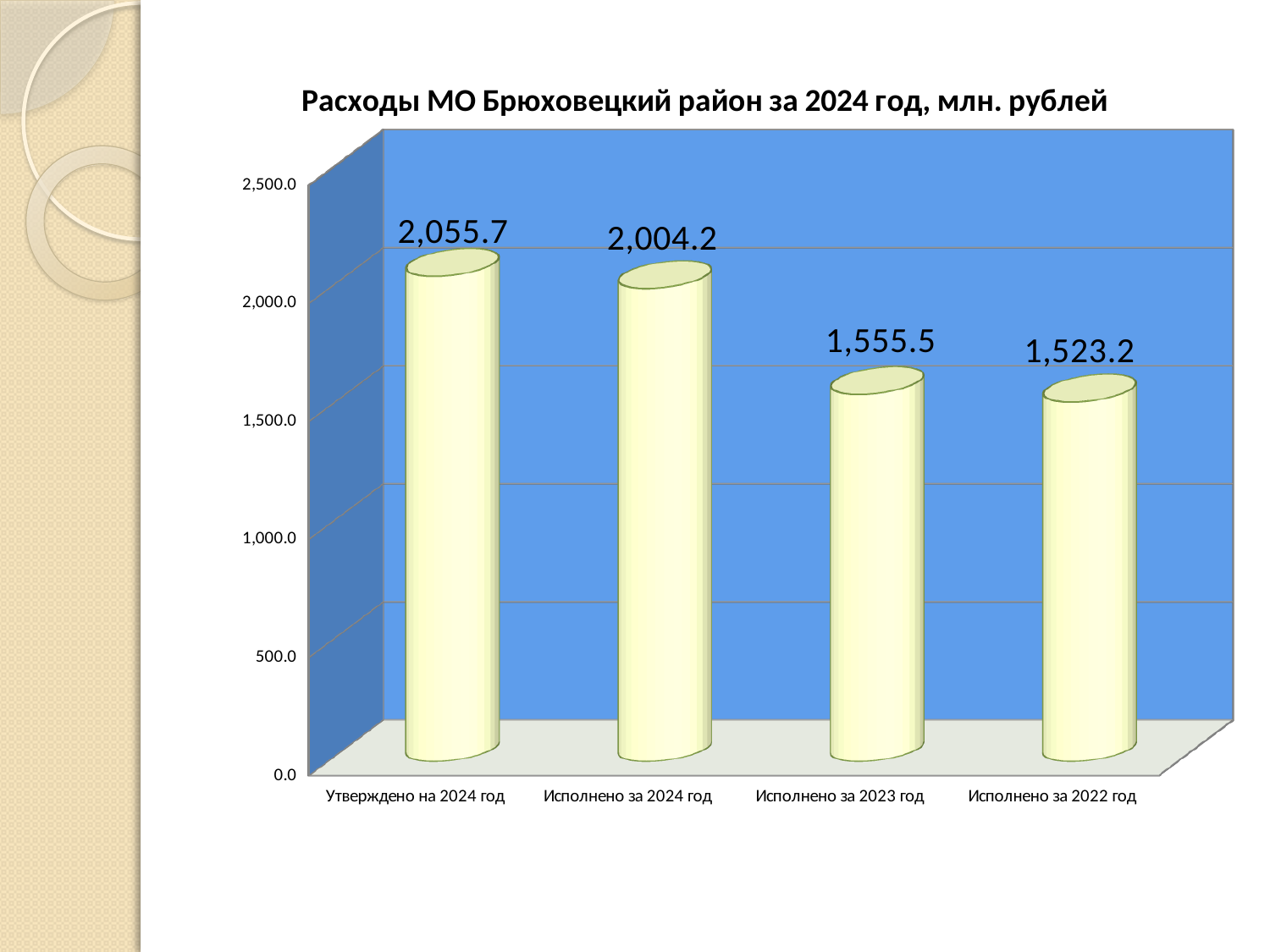
How many categories are shown on the chart? 4 Which is larger, the value for "Исполнено за 2024 год" or the value for "Исполнено за 2023 год"? Исполнено за 2024 год What is the difference between "Утверждено на 2024 год" and "Исполнено за 2024 год"? 51.5 What is the title of the chart? Расходы МО Брюховецкий район за 2024 год, млн. рублей Which category has the highest value? Утверждено на 2024 год What is the value for "Исполнено за 2022 год"? 1,523.2 Which category has the lowest value? Исполнено за 2022 год What kind of chart is shown on the slide? Bar chart What is the value for "Утверждено на 2024 год"? 2,055.7 What is the value for "Исполнено за 2024 год"? 2,004.2 What is the difference between "Исполнено за 2023 год" and "Исполнено за 2022 год"? 32.3 What is the value for "Исполнено за 2023 год"? 1,555.5